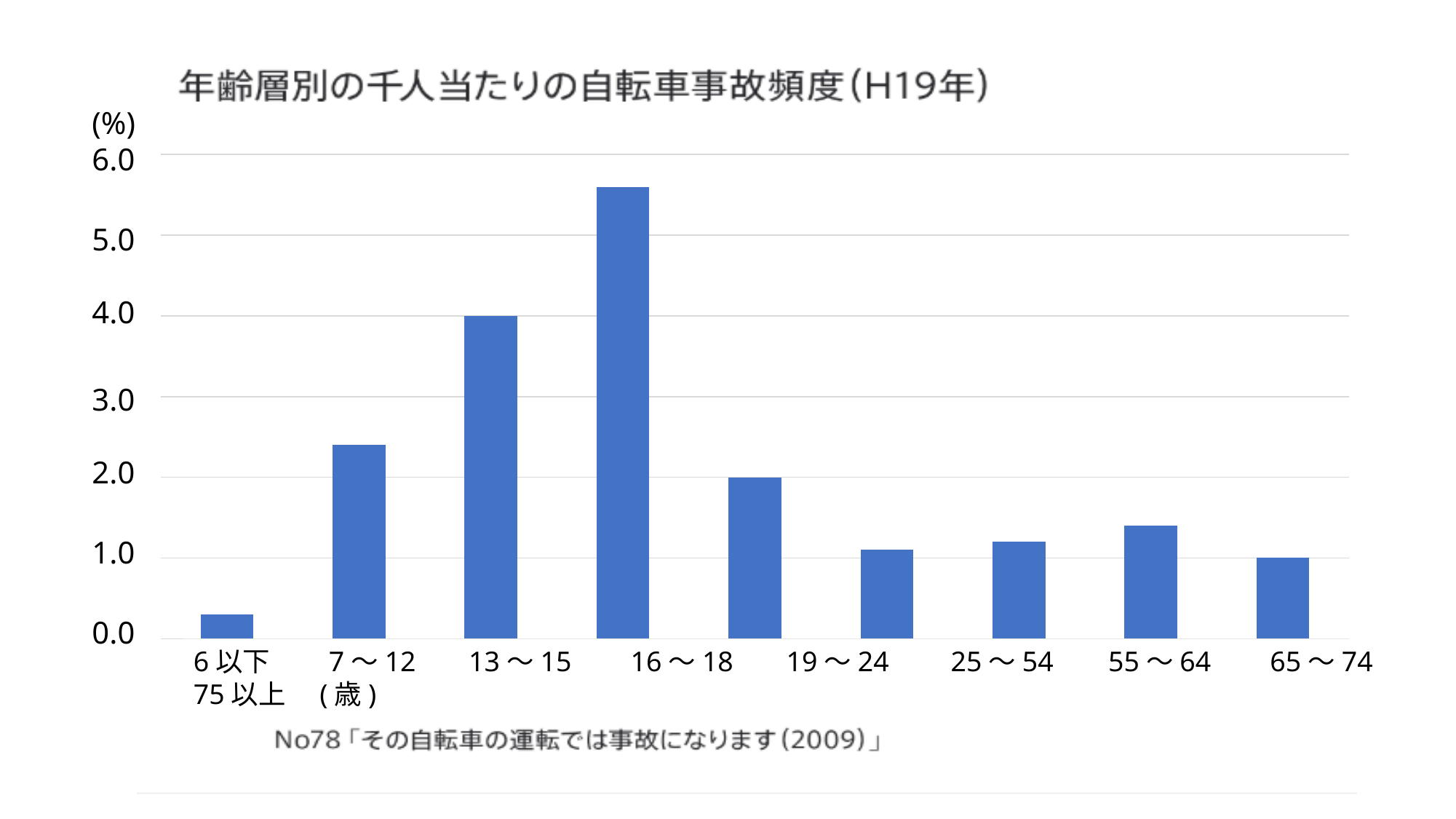
How many bars are plotted in the chart? 9 Which age group has the lowest bicycle accident frequency? 6以下 Which age group has the highest bicycle accident frequency? 16～18 What is the value for the 13～15 age group? 4.0 What is the title of the chart? 年齢層別の千人当たりの自転車事故頻度（H19年） Is the value for the 16～18 age group greater or less than 5.0? greater Is the value for the 7～12 age group greater or less than 2.0? greater What is the value for the 19～24 age group? 2.0 What kind of chart is shown on the slide? bar chart Which has the larger value, the 13～15 age group or the 19～24 age group? 13～15 Do the values rise or fall from the 6以下 group to the 16～18 group? rise Is the value for the 6以下 age group greater or less than 1.0? less